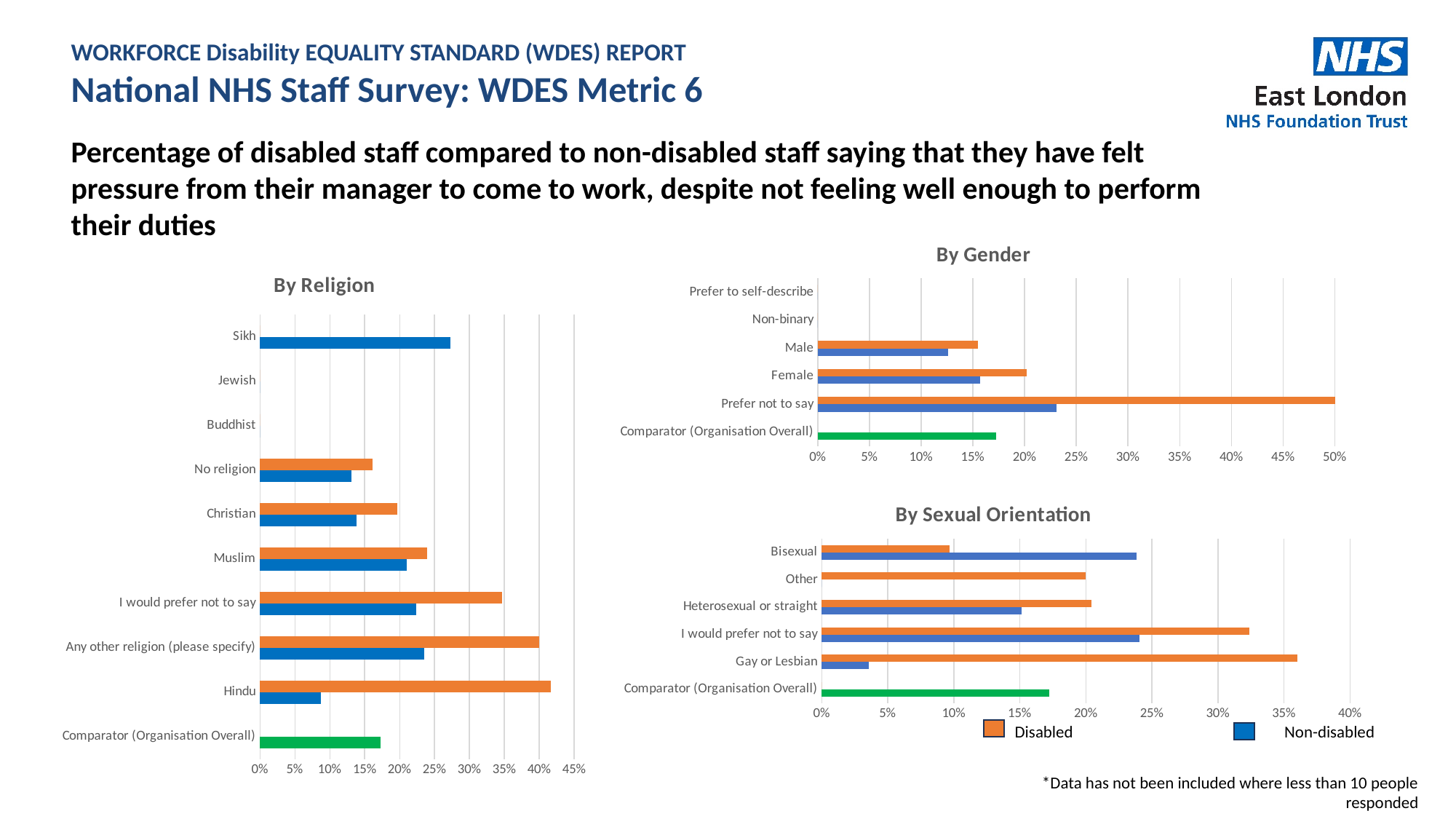
How many series does the legend list? 2 What type of chart is the 'By Religion' chart? bar chart In the 'By Religion' chart, which category has the lowest Non-disabled value among those with a Non-disabled bar? Hindu In the 'By Gender' chart, which is larger: the Disabled value for 'Female' or the Disabled value for 'Male'? Female In the 'By Sexual Orientation' chart, is the Non-disabled value for 'Gay or Lesbian' greater or less than 5%? less In the 'By Religion' chart, is the Non-disabled value for 'Sikh' greater or less than 25%? greater How many categories are shown on the 'By Gender' chart? 6 In the 'By Sexual Orientation' chart, which category has the highest Disabled value? Gay or Lesbian In the 'By Sexual Orientation' chart, which is larger for 'Bisexual': the Disabled value or the Non-disabled value? Non-disabled What colour is the 'Comparator (Organisation Overall)' bar in each chart? green How many categories are shown on the 'By Religion' chart? 10 In the 'By Gender' chart, is the Disabled value for 'Prefer not to say' greater or less than 45%? greater